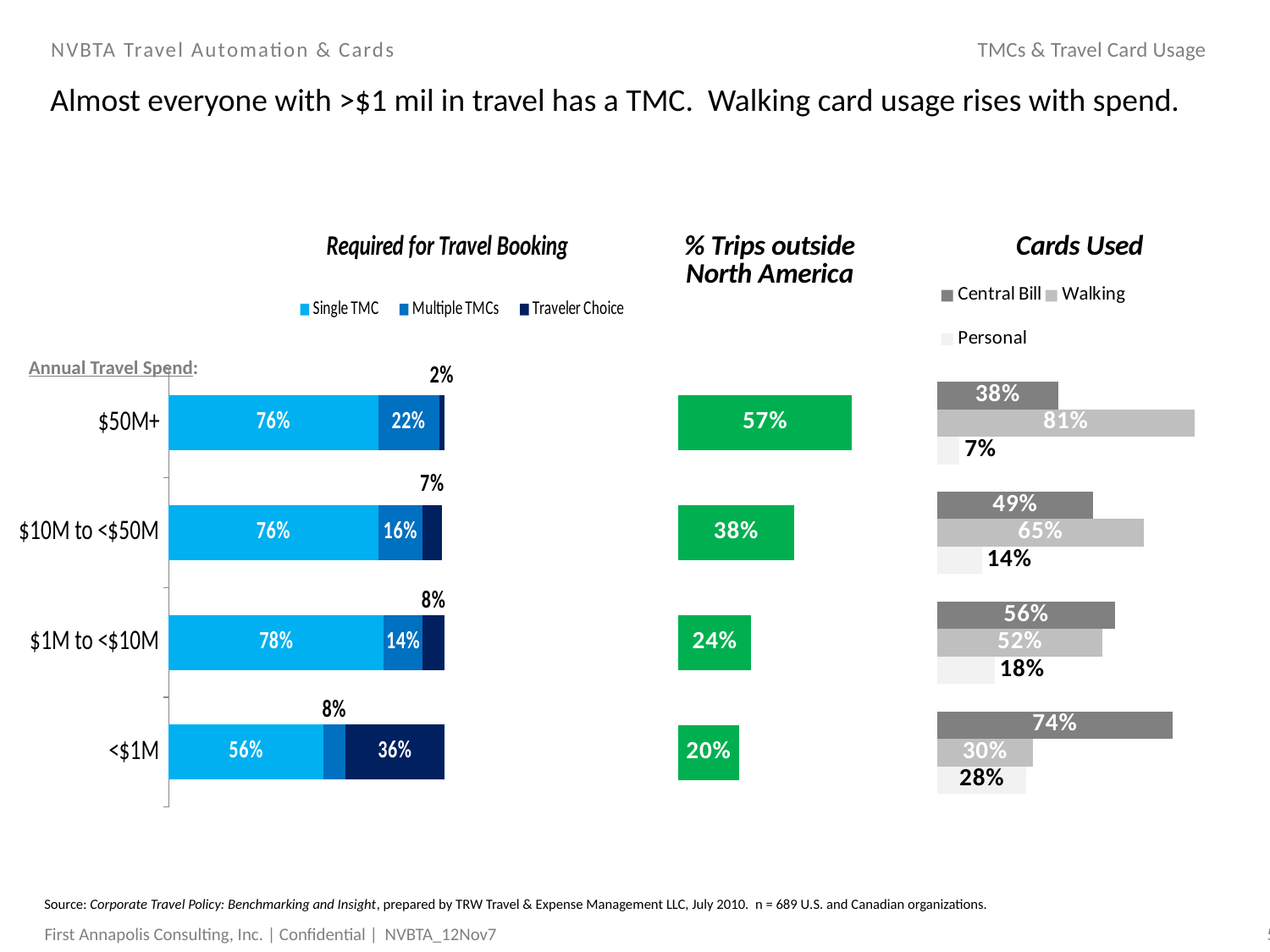
In the '% Trips outside North America' chart, what is the value for the $10M to <$50M spend group? 38% What type of chart is the 'Required for Travel Booking' chart? Stacked bar chart In the '% Trips outside North America' chart, what is the difference between the $50M+ value and the <$1M value? 37% In the 'Cards Used' chart, what is the Personal card value for the $50M+ spend group? 7% How many series does the legend of the 'Cards Used' chart list? 3 In the 'Required for Travel Booking' chart, what is the Traveler Choice value for the <$1M spend group? 36% In the '% Trips outside North America' chart, which spend group has the highest value? $50M+ In the 'Cards Used' chart, for the $1M to <$10M spend group, which is larger: Central Bill or Walking? Central Bill In the 'Cards Used' chart, which spend group has the lowest Walking card value? <$1M In the 'Required for Travel Booking' chart, what percentage of organizations with <$1M annual travel spend require a Single TMC? 56% How many annual travel spend categories are shown in the 'Required for Travel Booking' chart? 4 In the 'Cards Used' chart, does the Walking card value rise or fall as annual travel spend increases from <$1M to $50M+? Rises